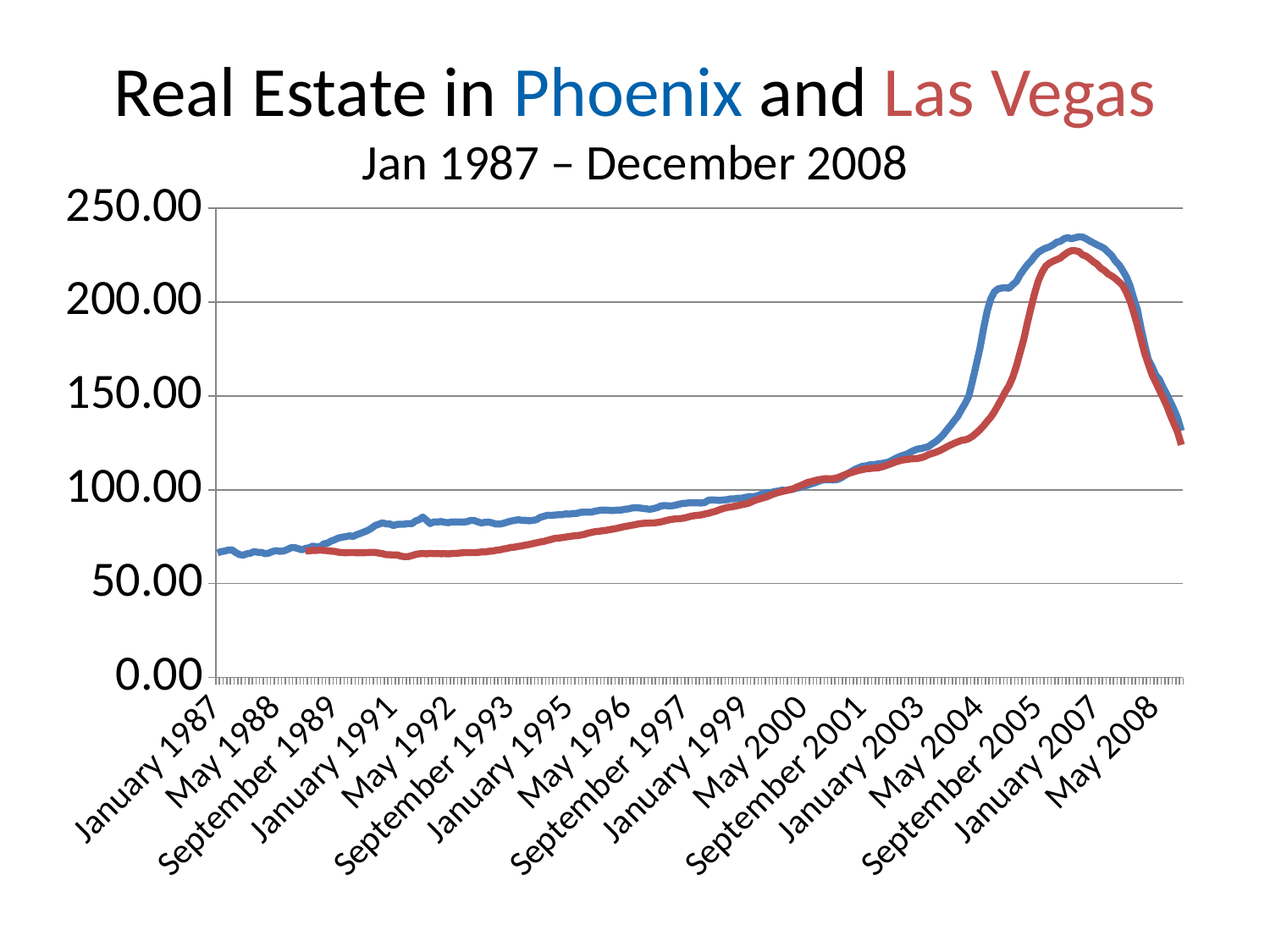
Which series is higher at September 2005, Phoenix or Las Vegas? Phoenix Is the value for Phoenix at January 2007 greater or less than 200? greater Is the value for Phoenix at January 1991 greater or less than 100? less How many series are plotted on the chart? 2 What kind of chart is shown on the slide? line chart What colour is the Las Vegas line? red What is the title of the chart? Real Estate in Phoenix and Las Vegas Is the value for Las Vegas at January 1995 greater or less than 100? less Which series reaches the higher peak value? Phoenix Which series is higher at January 1991, Phoenix or Las Vegas? Phoenix Does the Phoenix line rise or fall between January 2007 and May 2008? fall